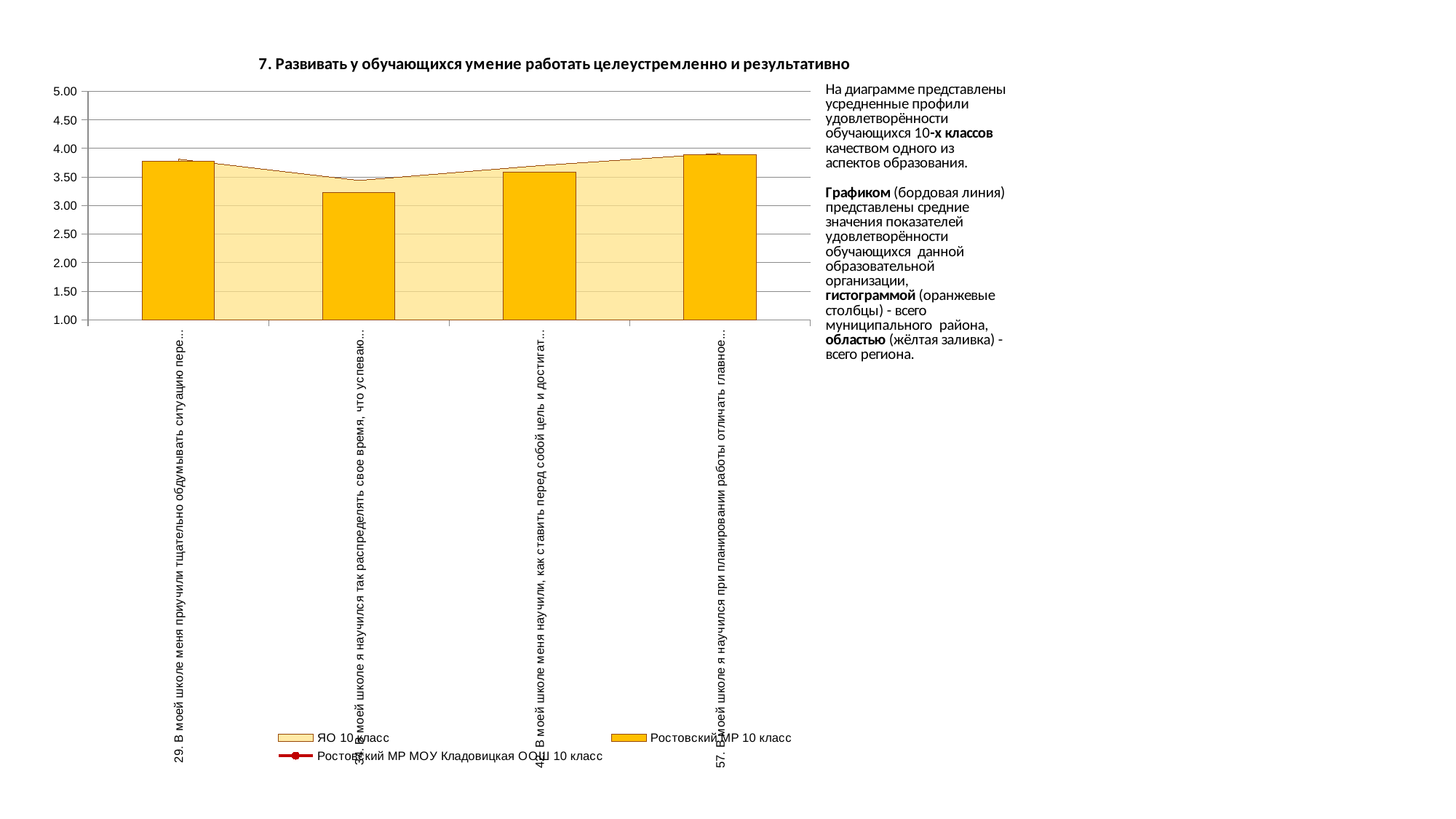
Is the Ростовский МР 10 класс value for category 29 greater or less than 3.50? greater Which is larger for Ростовский МР 10 класс: the second category or the third category? The third category Is the ЯО 10 класс value for the second category greater or less than 3.00? greater Is the Ростовский МР 10 класс value for the second category greater or less than 3.50? less What kind of chart is this? Combined bar and area chart How many series does the chart legend list? 3 Which category has the lowest orange bar (Ростовский МР 10 класс)? The second category Which colour represents the series Ростовский МР 10 класс in the legend? Orange What is the title of the chart? 7. Развивать у обучающихся умение работать целеустремленно и результативно Which category has the highest orange bar (Ростовский МР 10 класс)? 57. В моей школе я научился при планировании работы отличать главное... How many categories are shown on the x axis of the chart? 4